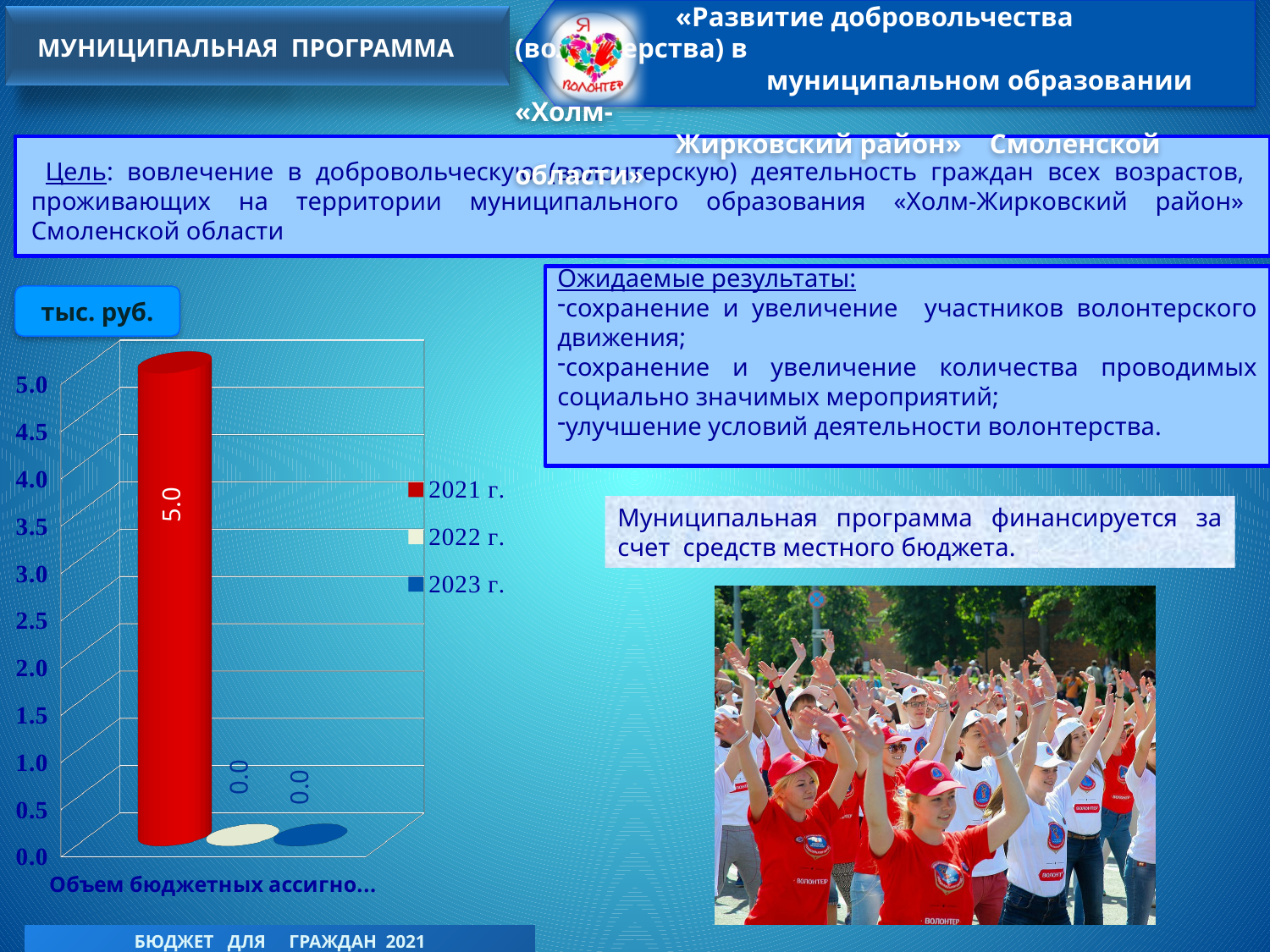
What is the value for 2021 г. in the chart? 5.0 What is the value for 2023 г. in the chart? 0.0 Which year has the highest value in the chart? 2021 г. What kind of chart is shown on the slide? bar chart What is the difference between the values for 2021 г. and 2022 г.? 5.0 Is the value for 2021 г. greater or less than 4.0? greater What is the value for 2022 г. in the chart? 0.0 What colour is the bar for 2021 г. in the chart? red What unit is shown in the label above the chart? тыс. руб. What is the total of the values for 2021 г., 2022 г. and 2023 г.? 5.0 How many series does the chart legend list? 3 Which is larger, the value for 2021 г. or the value for 2023 г.? 2021 г.